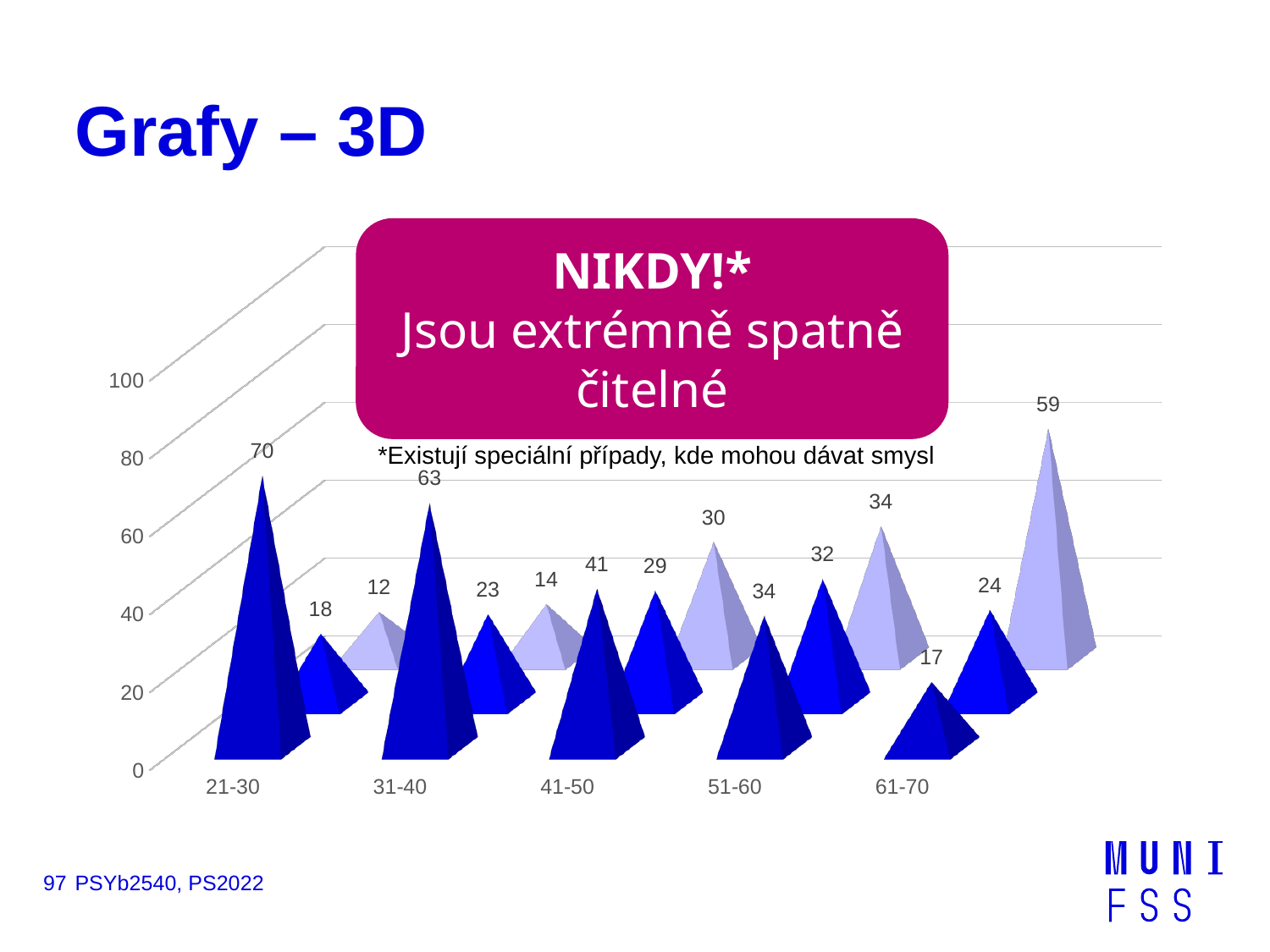
Which category has the lowest value in the light blue series? 21-30 How many age categories are shown on the x axis? 5 What is the value of the light blue series for the 61-70 category? 59 Which category has the highest value in the dark blue series? 21-30 What is the value of the medium blue series for the 31-40 category? 23 Which is larger: the light blue value for 61-70 or the dark blue value for 61-70? light blue (59) What kind of chart is shown on the slide? 3D bar chart What is the title of the slide containing the chart? Grafy – 3D Do the values of the light blue series rise or fall from 21-30 to 61-70? rise Do the values of the dark blue series rise or fall from 21-30 to 61-70? fall What is the value of the dark blue series for the 21-30 category? 70 What is the difference between the dark blue values for 21-30 and 31-40? 7